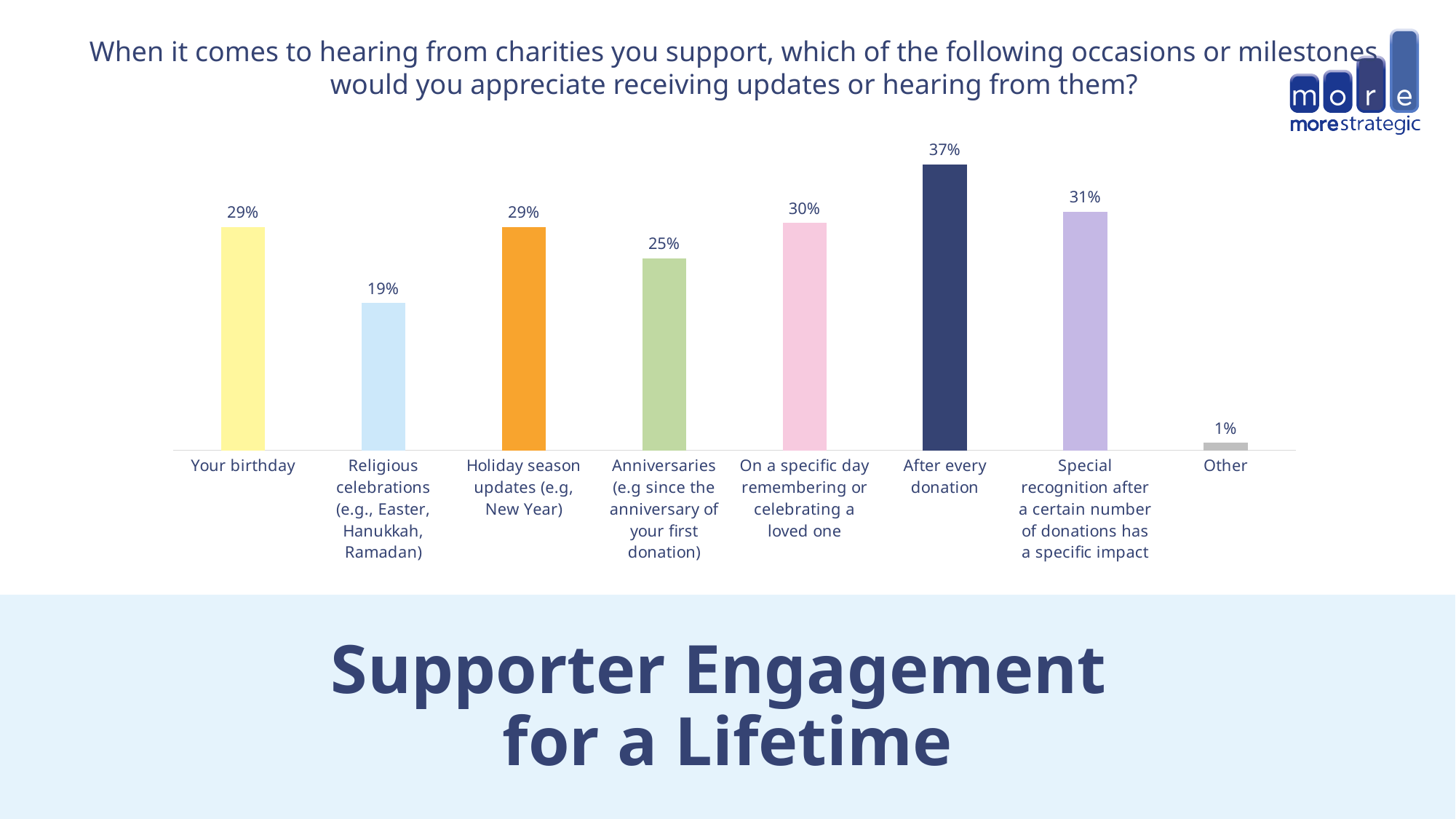
What is the difference between 'After every donation' and 'Your birthday'? 8% What is the value for 'Anniversaries (e.g since the anniversary of your first donation)'? 25% What is the value for 'Religious celebrations (e.g., Easter, Hanukkah, Ramadan)'? 19% What type of chart is shown on the slide? Bar chart What is the value for 'Special recognition after a certain number of donations has a specific impact'? 31% What is the difference between 'On a specific day remembering or celebrating a loved one' and 'Religious celebrations'? 11% Which occasion has the highest percentage? After every donation How many categories are shown in the chart? 8 Which category has the lowest percentage? Other What colour is the bar for 'After every donation'? Dark navy blue Which is larger: 'Special recognition after a certain number of donations has a specific impact' or 'Holiday season updates (e.g, New Year)'? Special recognition after a certain number of donations has a specific impact What percentage of respondents would appreciate hearing from charities after every donation? 37%